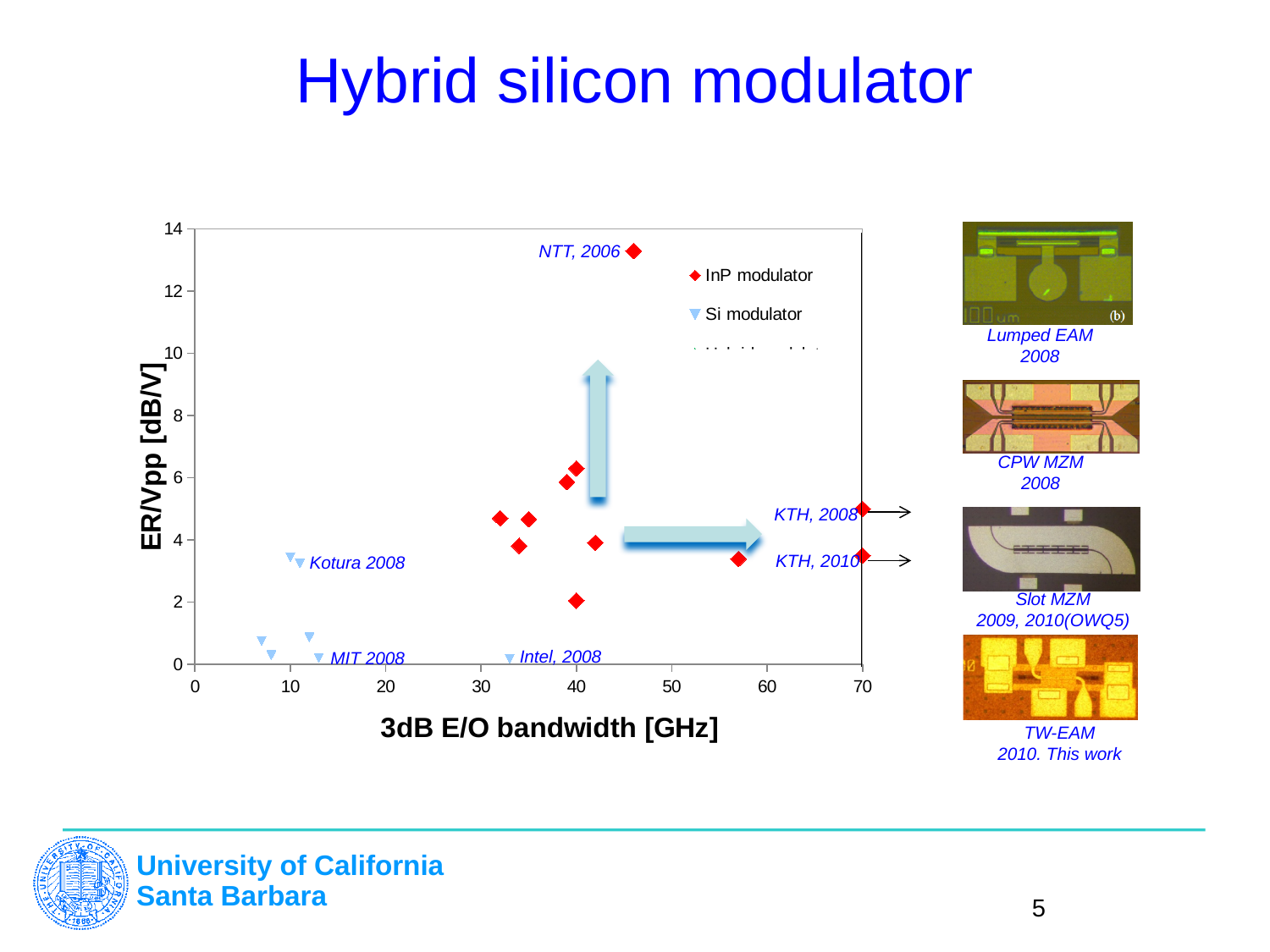
Which labeled data point has the highest ER/Vpp value? NTT, 2006 Is the ER/Vpp value for Kotura 2008 greater or less than 4? less What is the title of the x axis? 3dB E/O bandwidth [GHz] Is the 3dB E/O bandwidth for KTH, 2008 greater or less than 60? greater What kind of chart is shown on the slide? scatter chart Is the ER/Vpp value for NTT, 2006 greater or less than 12? greater Which has the higher 3dB E/O bandwidth, Kotura 2008 or Intel, 2008? Intel, 2008 Which has the higher ER/Vpp value, KTH, 2008 or KTH, 2010? KTH, 2008 What is the title of the y axis? ER/Vpp [dB/V] How many data points on the chart are labeled with a name and year? 6